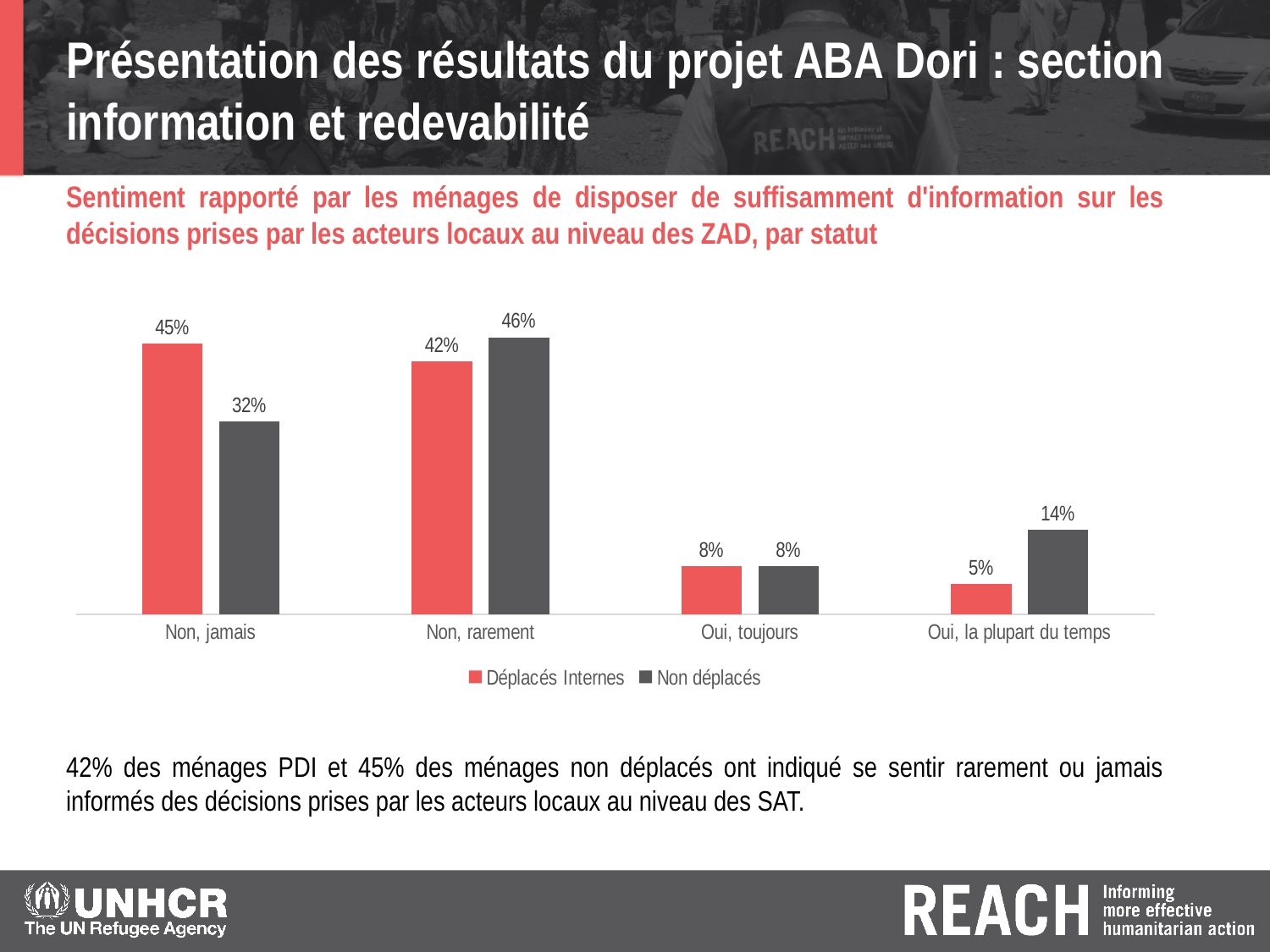
How many categories are shown on the x axis of the chart? 4 What is the value for Non déplacés in the 'Non, rarement' category? 46% What is the difference between the Déplacés Internes and Non déplacés values in the 'Non, jamais' category? 13% Which series is shown in red in the chart? Déplacés Internes What kind of chart is shown on the slide? Bar chart What is the value for Non déplacés in the 'Oui, toujours' category? 8% What is the value for Déplacés Internes in the 'Oui, la plupart du temps' category? 5% Which category has the lowest value for Déplacés Internes? Oui, la plupart du temps Which category has the highest value for Non déplacés? Non, rarement What is the value for Déplacés Internes in the 'Non, jamais' category? 45% In the 'Oui, la plupart du temps' category, which series has the larger value, Déplacés Internes or Non déplacés? Non déplacés How many series does the legend list? 2